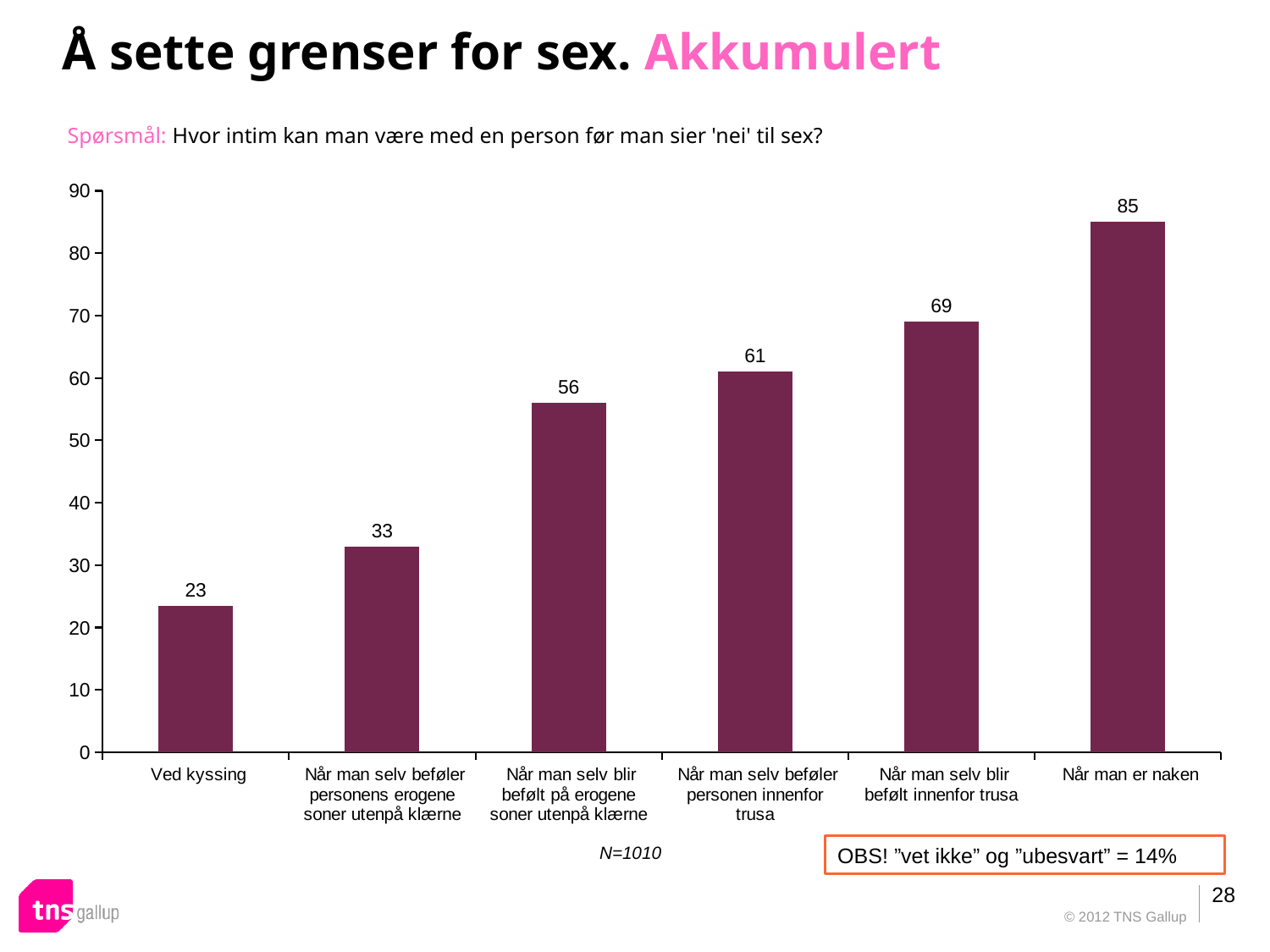
Do the values rise or fall from left to right along the x axis? Rise What is the value for "Ved kyssing"? 23 What is the difference between the values for "Når man selv blir befølt på erogene soner utenpå klærne" and "Når man selv beføler personens erogene soner utenpå klærne"? 23 Which category has the highest value? Når man er naken What kind of chart is shown on the slide? Bar chart What is the difference between the values for "Når man er naken" and "Ved kyssing"? 62 What is the value for "Når man er naken"? 85 What is the sample size (N) stated below the chart? N=1010 What is the value for "Når man selv blir befølt innenfor trusa"? 69 How many categories are shown on the x axis? 6 Which is larger: the value for "Når man selv beføler personen innenfor trusa" or "Når man selv blir befølt på erogene soner utenpå klærne"? Når man selv beføler personen innenfor trusa Which category has the lowest value? Ved kyssing